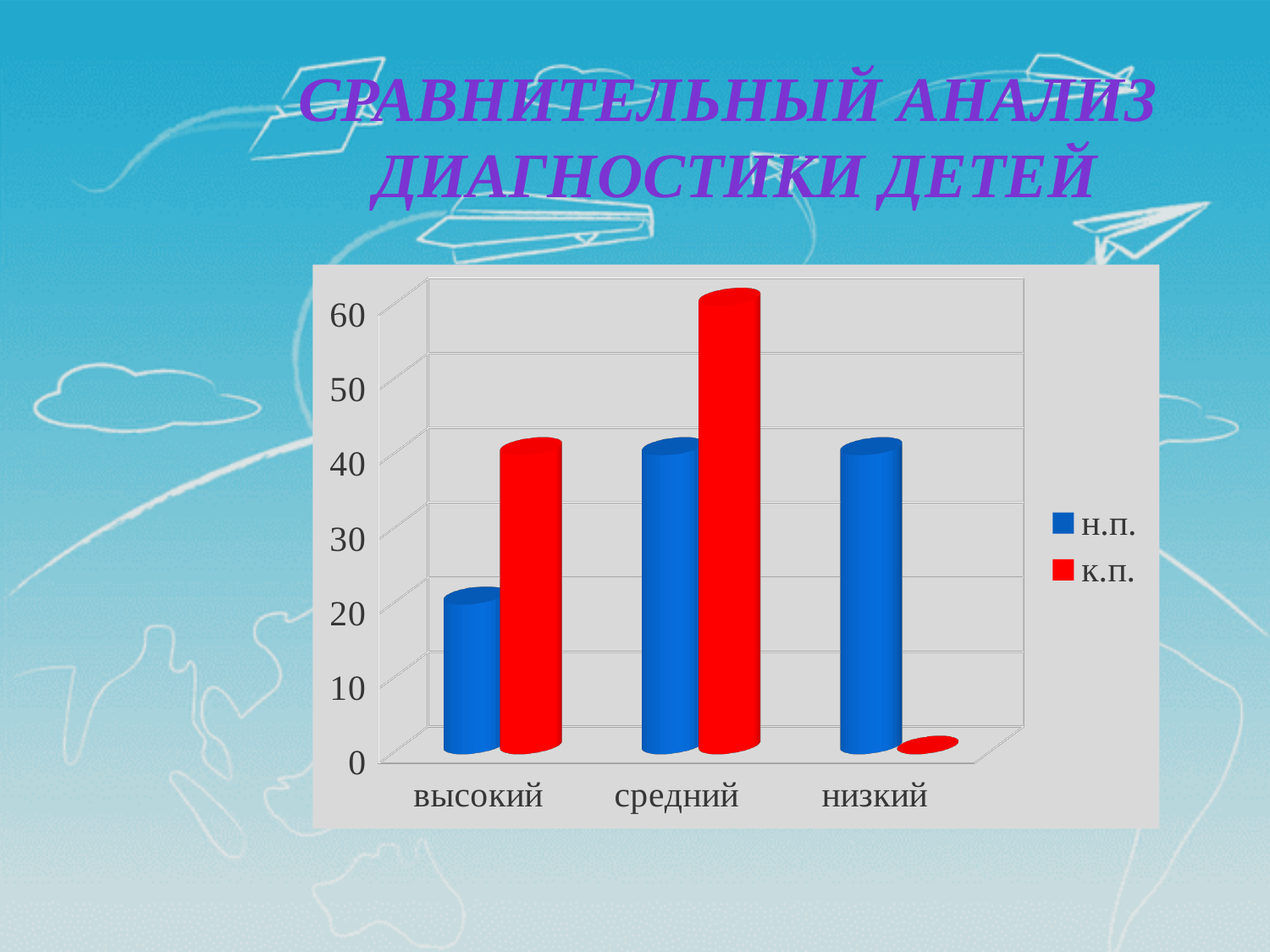
For the category низкий, which series has the larger value, н.п. or к.п.? н.п. Which category has the lowest value for the н.п. series? высокий How many series does the chart's legend list? 2 What colour are the bars for the к.п. series? red Is the к.п. value for средний greater or less than 50? greater What kind of chart is shown on the slide? bar chart For the category высокий, which series has the larger value, н.п. or к.п.? к.п. How many categories are shown on the x axis of the chart? 3 Which category has the lowest value for the к.п. series? низкий Is the к.п. value for низкий greater or less than 10? less Is the н.п. value for высокий greater or less than 30? less Which category has the highest value for the к.п. series? средний